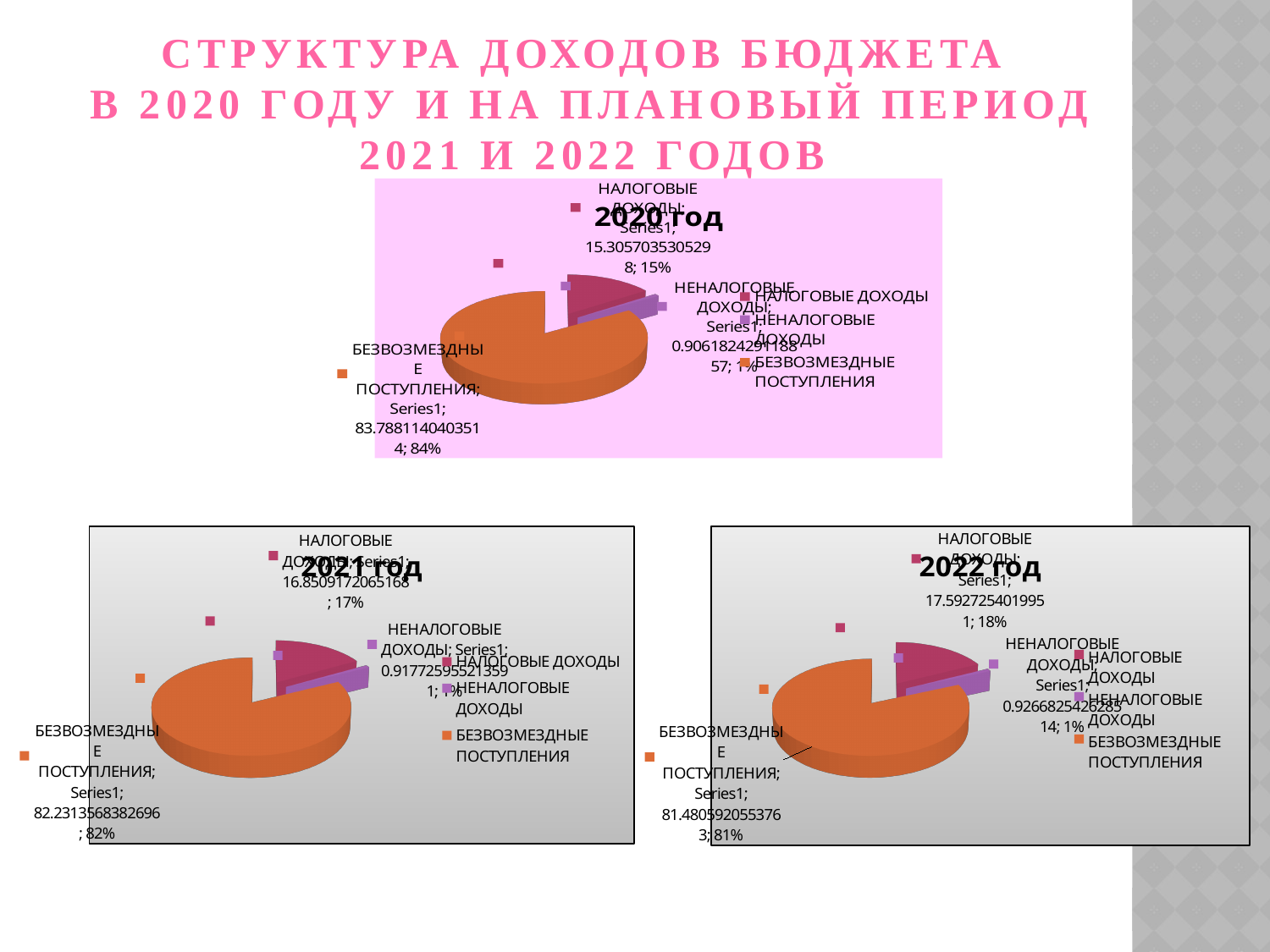
In the chart titled "2021 год", which category has the smallest slice? НЕНАЛОГОВЫЕ ДОХОДЫ In the chart titled "2020 год", what share of the pie is НАЛОГОВЫЕ ДОХОДЫ? 15% How many categories does the legend of the chart titled "2020 год" list? 3 In the chart titled "2022 год", which is larger: НАЛОГОВЫЕ ДОХОДЫ or НЕНАЛОГОВЫЕ ДОХОДЫ? НАЛОГОВЫЕ ДОХОДЫ In the chart titled "2022 год", what share of the pie is НАЛОГОВЫЕ ДОХОДЫ? 18% In the chart titled "2021 год", what share of the pie is НАЛОГОВЫЕ ДОХОДЫ? 17% In the chart titled "2020 год", which category has the largest slice? БЕЗВОЗМЕЗДНЫЕ ПОСТУПЛЕНИЯ What type of chart is the chart titled "2021 год"? Pie chart